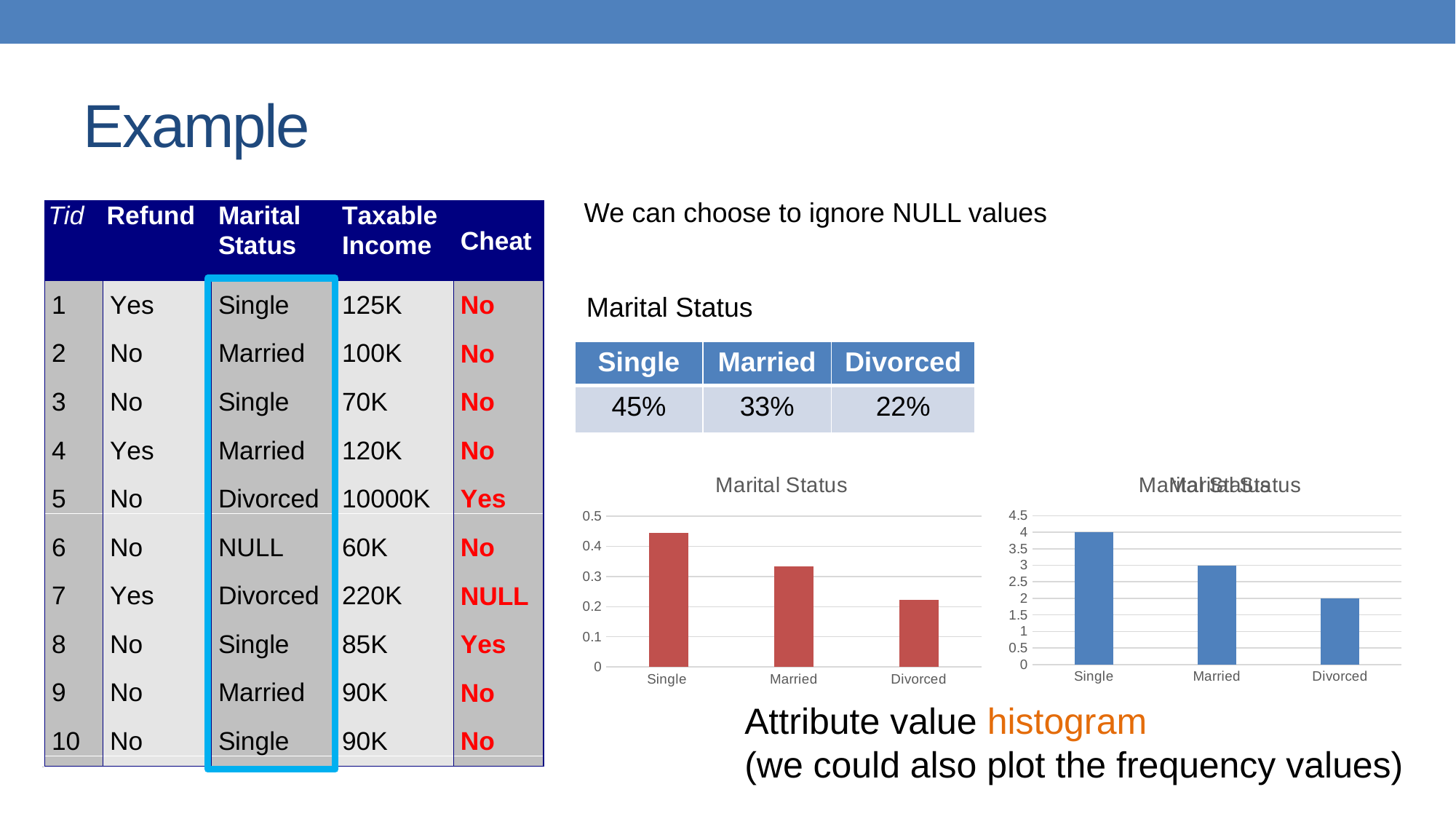
What type of chart is the left chart titled Marital Status with red bars? bar chart In the left chart with red bars, is the value for Single greater or less than 0.4? greater In the left chart with red bars, do the values rise or fall from Single to Divorced? fall In the left chart with red bars, which category has the lowest value? Divorced In the left chart with red bars, how many categories are shown on the x axis? 3 In the right chart with blue bars, what is the value for Divorced? 2 In the right chart with blue bars, what is the value for Single? 4 In the left chart with red bars, which category has the highest value? Single In the left chart with red bars, is the value for Divorced greater or less than 0.3? less In the right chart with blue bars, which is larger, the value for Married or the value for Divorced? Married In the right chart with blue bars, what is the value for Married? 3 In the right chart with blue bars, what is the difference between the values for Single and Divorced? 2